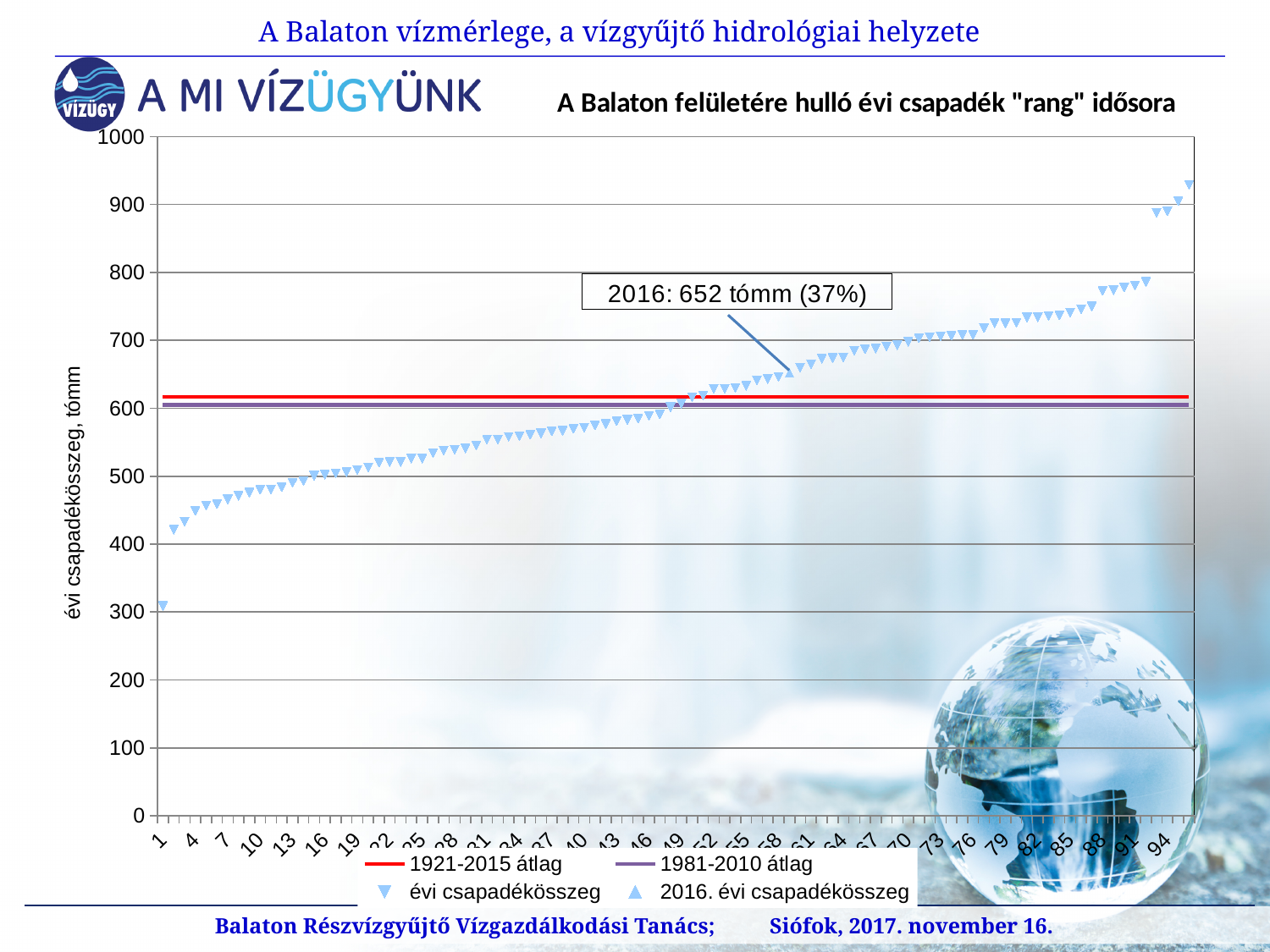
Is the 1921-2015 átlag line greater or less than 600? greater What percentage is given in the annotation for the 2016 value? 37% How many series does the chart legend list? 4 What kind of chart is shown on the slide? line chart Is the 1981-2010 átlag line greater or less than 700? less Do the évi csapadékösszeg values rise or fall along the x axis? rise What is the title of the chart? A Balaton felületére hulló évi csapadék "rang" idősora Which is higher, the 1921-2015 átlag line or the 1981-2010 átlag line? 1921-2015 átlag Is the value at rank 1 greater or less than 400? less Is the 2016 value above or below the 1921-2015 átlag line? above What is the annual precipitation value for 2016 shown in the chart annotation? 652 tómm